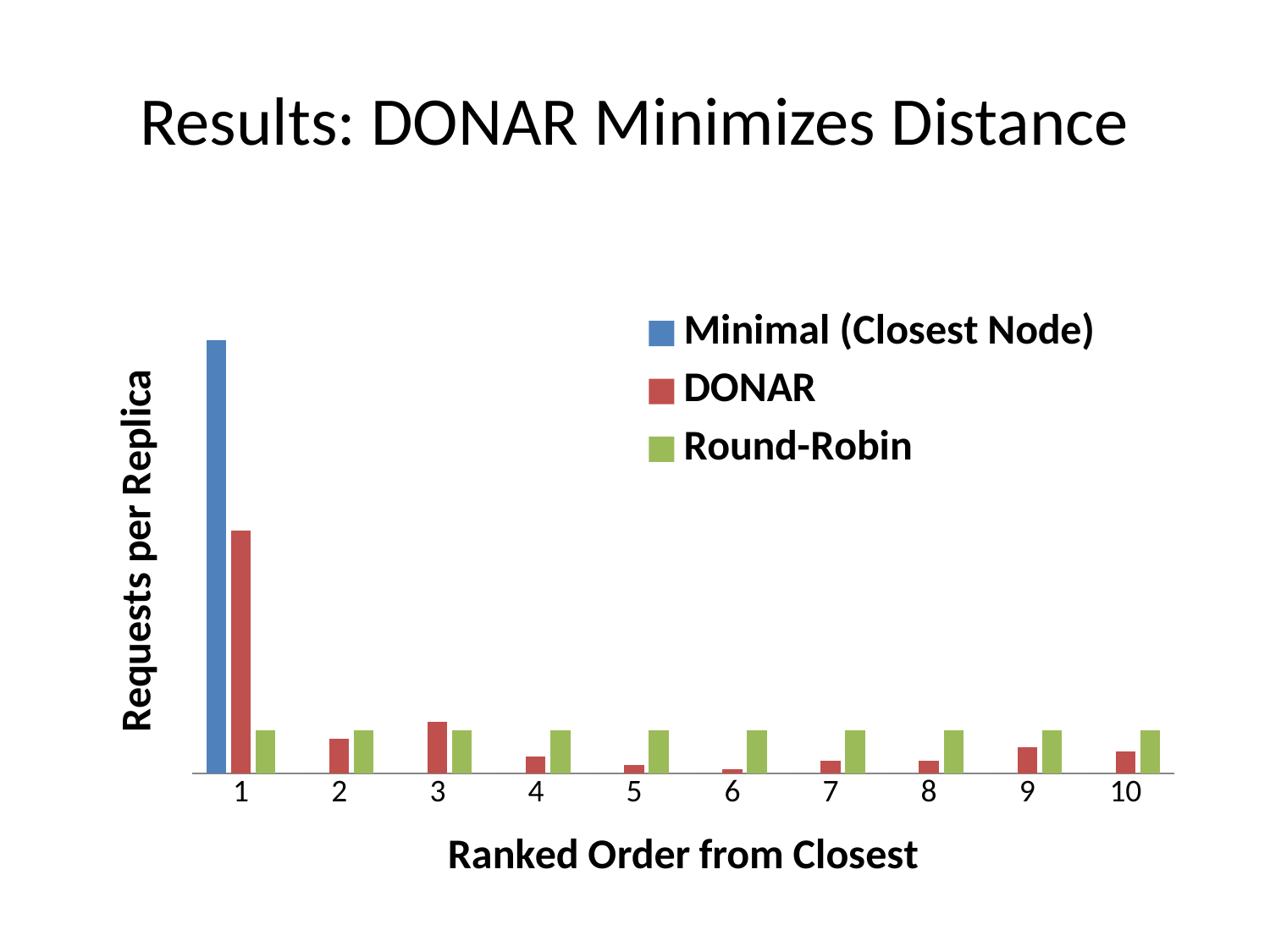
At ranked position 3, which is larger: DONAR or Round-Robin? DONAR What kind of chart is shown on the slide? bar chart At ranked position 2, which is larger: DONAR or Round-Robin? Round-Robin How many ranked positions are shown along the x axis? 10 At ranked position 1, which is larger: DONAR or Round-Robin? DONAR What is the title of the y axis? Requests per Replica Do the DONAR values rise or fall from ranked position 1 to ranked position 6? fall At which ranked position is the DONAR value lowest? 6 Which series has the tallest bar on the chart? Minimal (Closest Node) At which ranked position is the DONAR value highest? 1 How many series does the legend list? 3 What is the title of the x axis? Ranked Order from Closest